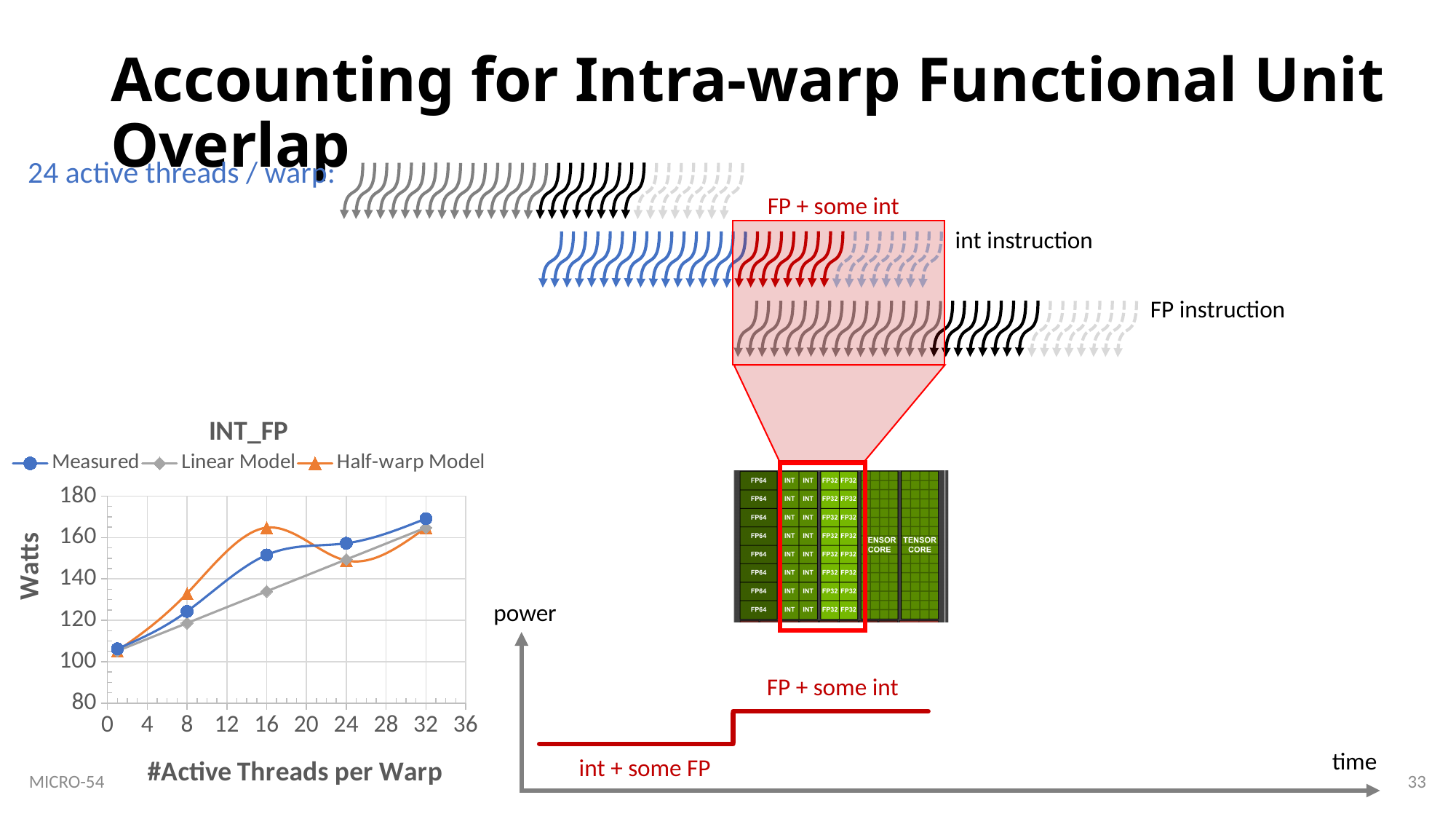
In the INT_FP chart, is the Measured value at 32 active threads per warp greater or less than 160? greater In the INT_FP chart, is the Half-warp Model value at 16 active threads per warp greater or less than 160? greater What is the title of the chart on the slide? INT_FP What is the label of the y axis of the INT_FP chart? Watts In the INT_FP chart, does the Measured series generally rise or fall as the number of active threads per warp increases? rise In the INT_FP chart, which series has the lowest value at 16 active threads per warp? Linear Model How many series does the legend of the INT_FP chart list? 3 In the INT_FP chart, which series has the highest value at 16 active threads per warp? Half-warp Model What kind of chart is the INT_FP chart? line chart In the INT_FP chart, at 8 active threads per warp, which is larger: the Half-warp Model value or the Linear Model value? Half-warp Model In the INT_FP chart, is the Linear Model value at 16 active threads per warp greater or less than 140? less How many data points does the Measured series have in the INT_FP chart? 5